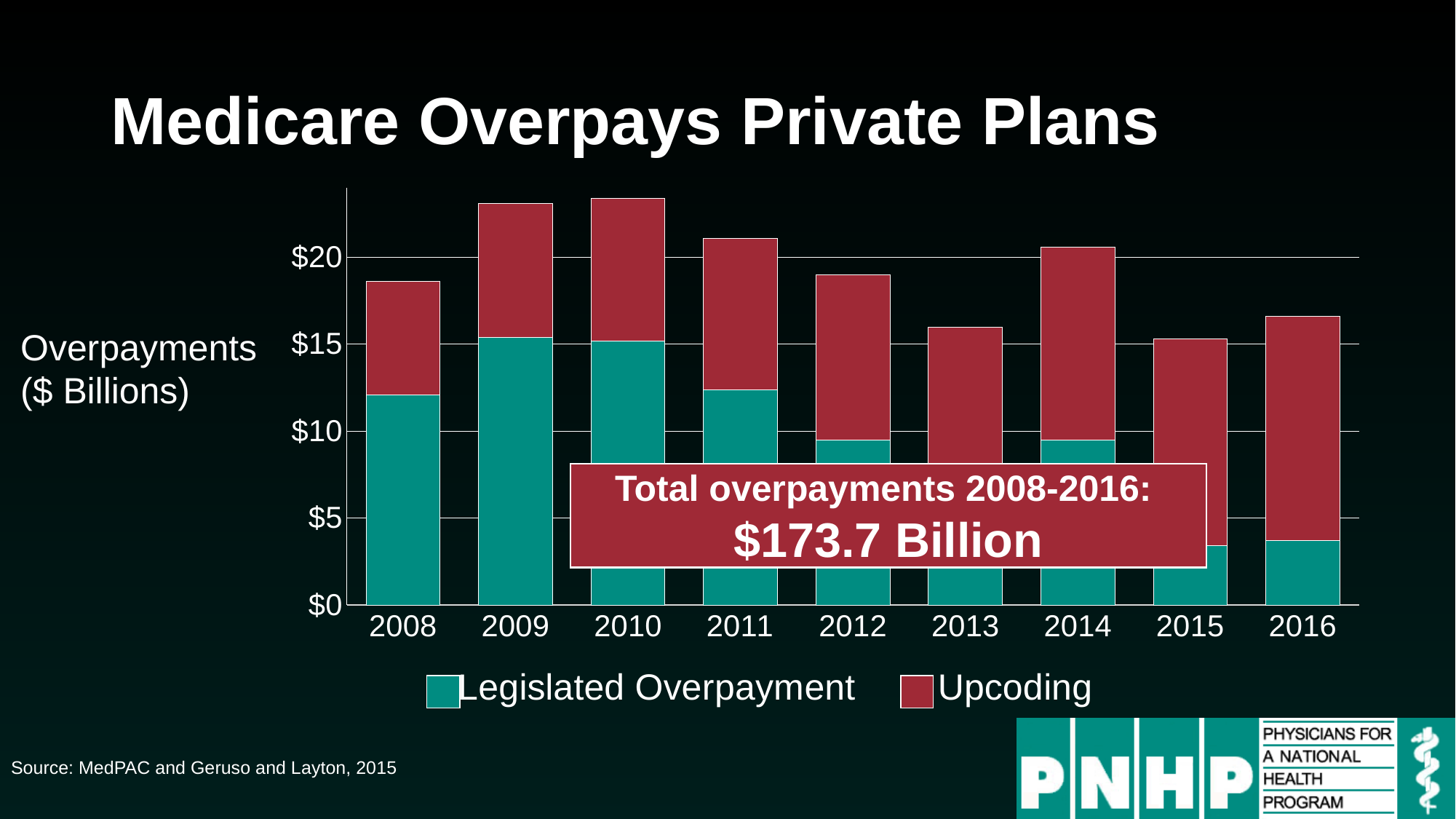
Is the total overpayment bar for 2009 greater or less than $20? greater What kind of chart is shown on the slide? Stacked bar chart Is the Legislated Overpayment portion for 2015 greater or less than $5? less What total overpayment figure for 2008-2016 is printed on the chart? $173.7 Billion How many series does the chart's legend list? 2 Is the total overpayment bar for 2008 greater or less than $15? greater What are the two series named in the legend? Legislated Overpayment and Upcoding Does the Legislated Overpayment portion generally rise or fall from 2008 to 2016? fall How many years are shown on the x axis of the chart? 9 Which year has the larger total overpayment bar, 2011 or 2015? 2011 Which year has the lowest total overpayment bar? 2015